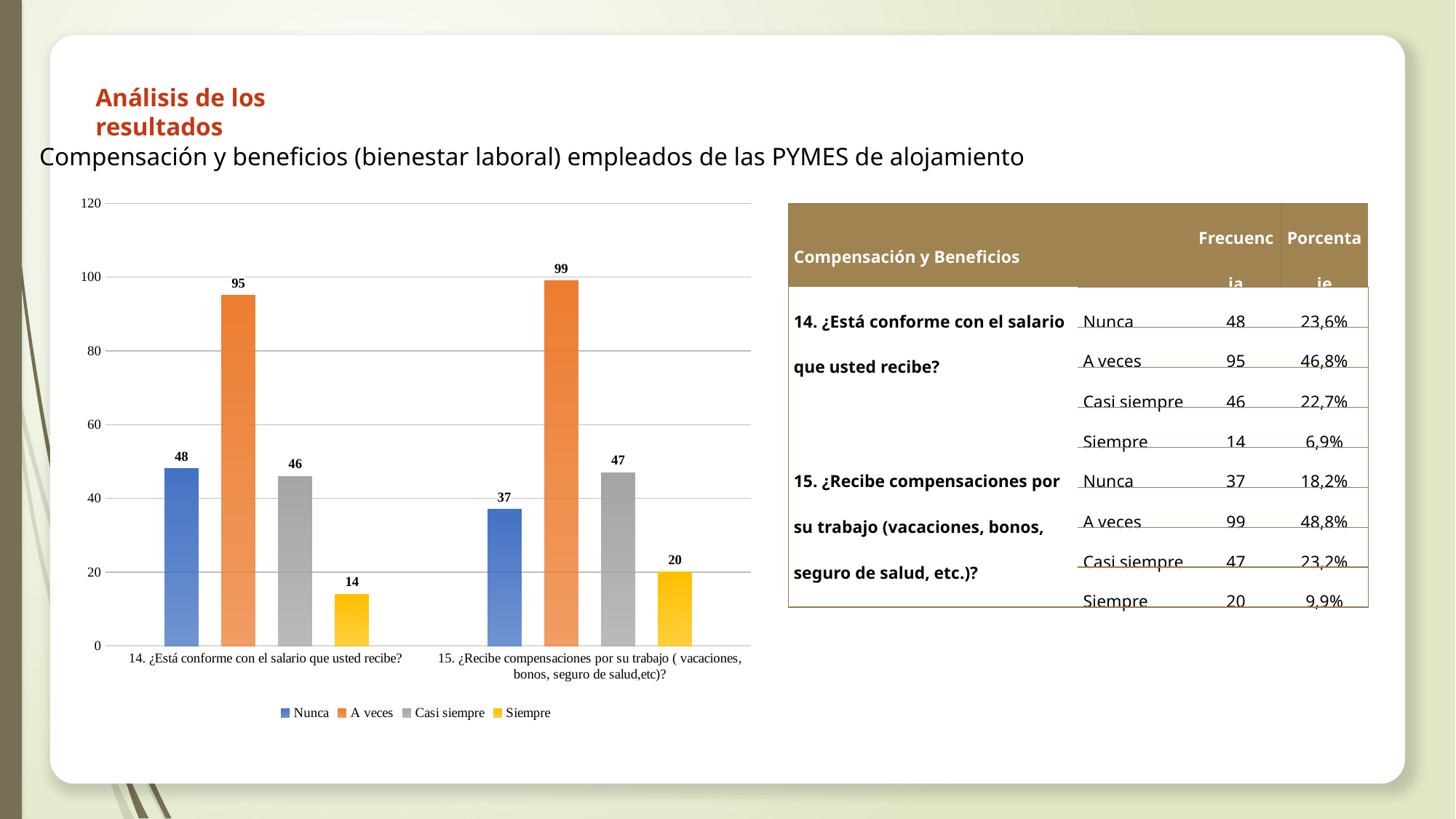
Which is larger: 'Nunca' for question 14 or 'Nunca' for question 15? Nunca for question 14 Which series has the lowest value for question 15 (¿Recibe compensaciones por su trabajo?)? Siempre What is the value for 'A veces' for question 14 (¿Está conforme con el salario que usted recibe?)? 95 What is the value for 'Siempre' for question 15 (¿Recibe compensaciones por su trabajo?)? 20 Which series has the highest value for question 14 (¿Está conforme con el salario que usted recibe?)? A veces What is the value for 'Nunca' for question 15 (¿Recibe compensaciones por su trabajo?)? 37 How many question categories are shown on the x axis? 2 How many series does the legend list? 4 Is the value for 'A veces' for question 15 greater or less than 80? greater What is the difference between 'Nunca' and 'Siempre' for question 14 (¿Está conforme con el salario que usted recibe?)? 34 What kind of chart is shown on the slide? Bar chart What is the difference between the 'A veces' values for question 15 and question 14? 4